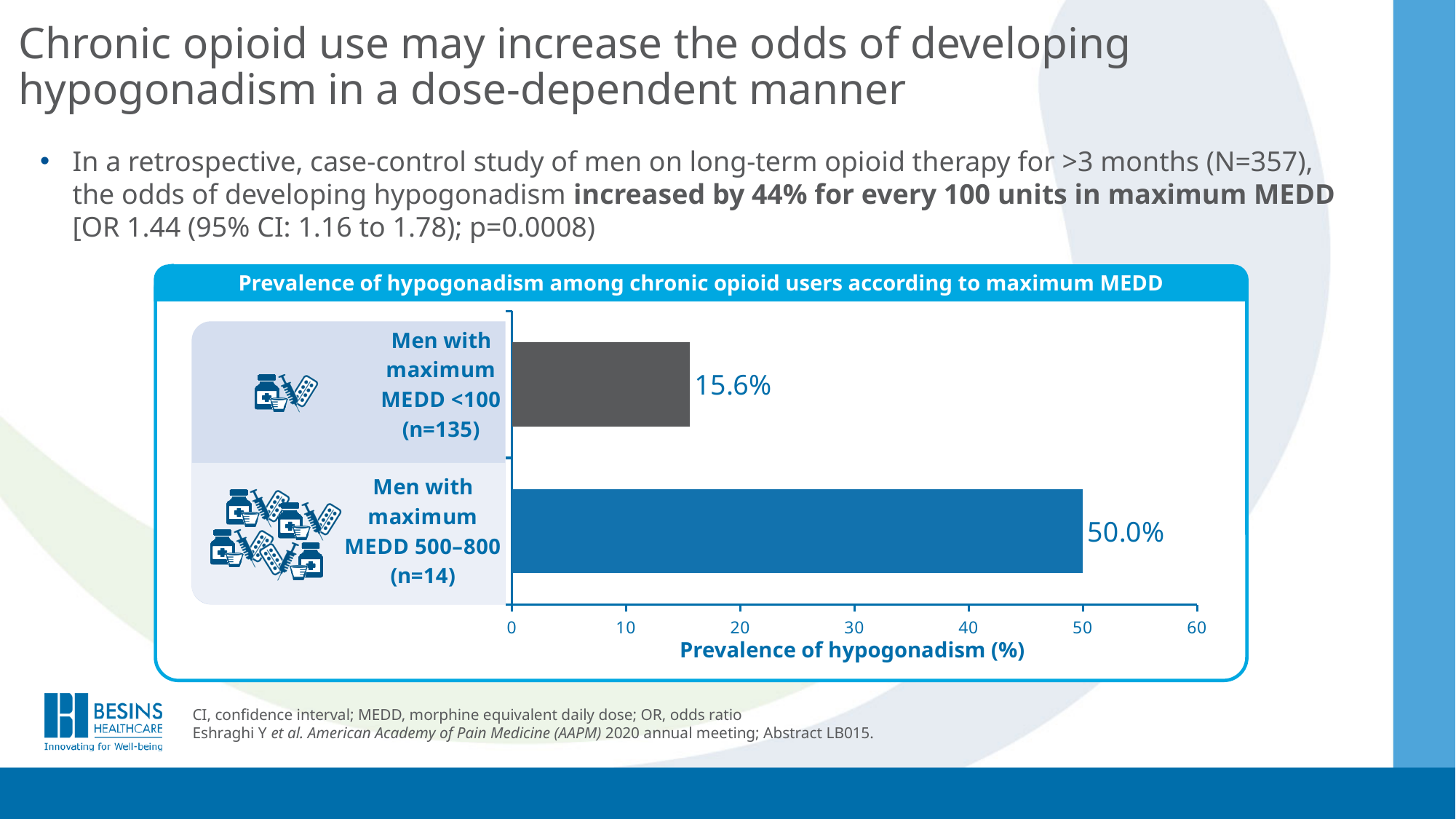
What is the sample size (n) of the group with maximum MEDD 500–800? n=14 How many groups are shown in the chart? 2 Is the prevalence of hypogonadism higher for men with maximum MEDD <100 or for men with maximum MEDD 500–800? Men with maximum MEDD 500–800 What is the prevalence of hypogonadism for men with maximum MEDD <100? 15.6% What is the label of the x axis of the chart? Prevalence of hypogonadism (%) Which group has the higher prevalence of hypogonadism? Men with maximum MEDD 500–800 What is the prevalence of hypogonadism for men with maximum MEDD 500–800? 50.0% Is the prevalence of hypogonadism for men with maximum MEDD <100 greater or less than 20? less What is the difference in prevalence of hypogonadism between the MEDD 500–800 group and the MEDD <100 group? 34.4% Which group has the lower prevalence of hypogonadism? Men with maximum MEDD <100 What kind of chart is shown on the slide? Bar chart What is the title of the chart? Prevalence of hypogonadism among chronic opioid users according to maximum MEDD